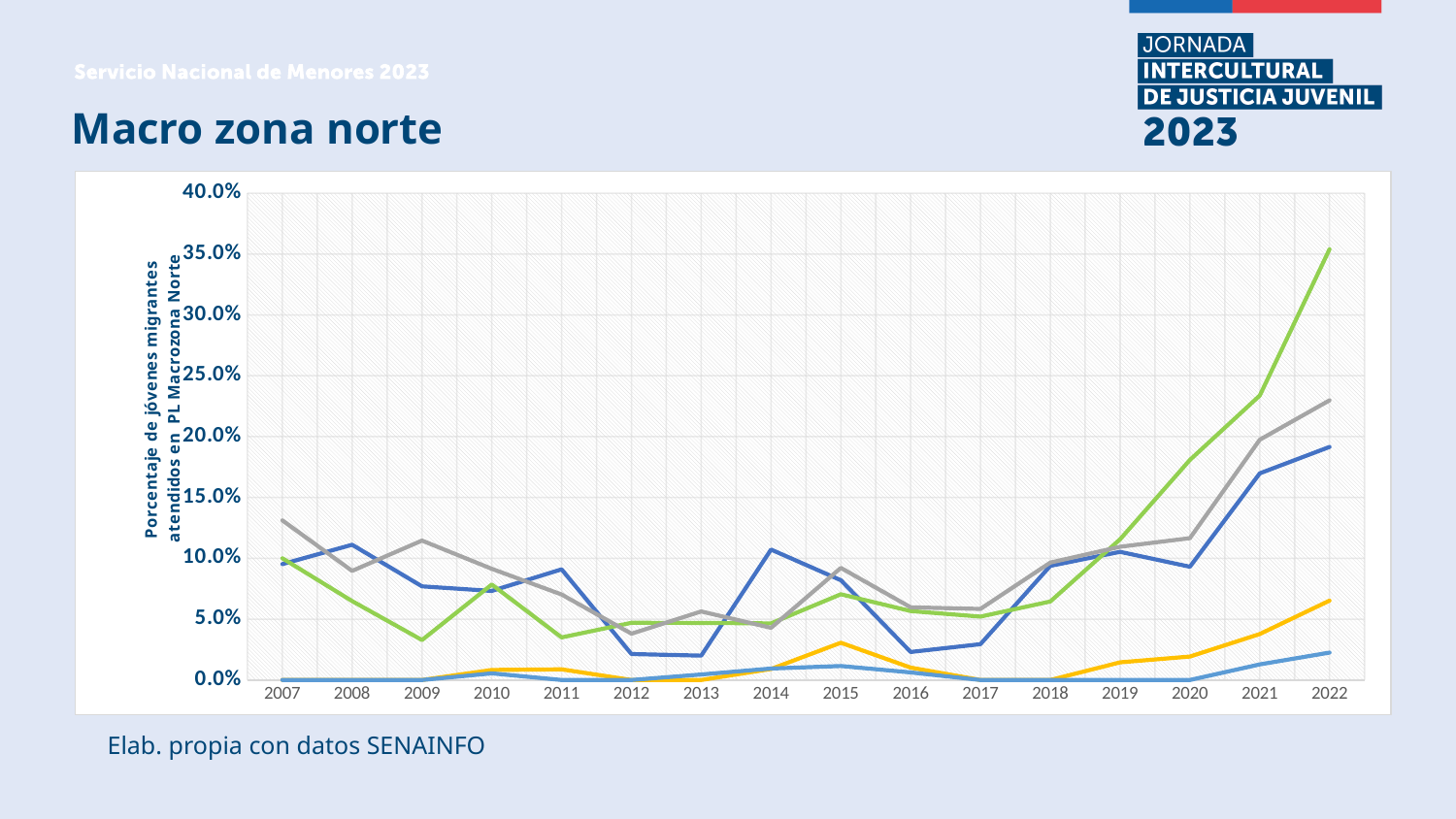
Is the value of the dark blue line in 2022 greater or less than 20.0%? less Which line has the highest value in 2022? the green line How many years are shown along the x axis of the chart? 16 How many lines are plotted on the chart? 5 In which year does the green line reach its highest value? 2022 Does the green line rise or fall between 2018 and 2022? rise Is the value of the grey line in 2022 greater or less than 20.0%? greater Is the value of the green line in 2022 greater or less than 30.0%? greater What kind of chart is shown on the slide? line chart What is the last year shown on the x axis? 2022 What is the first year shown on the x axis? 2007